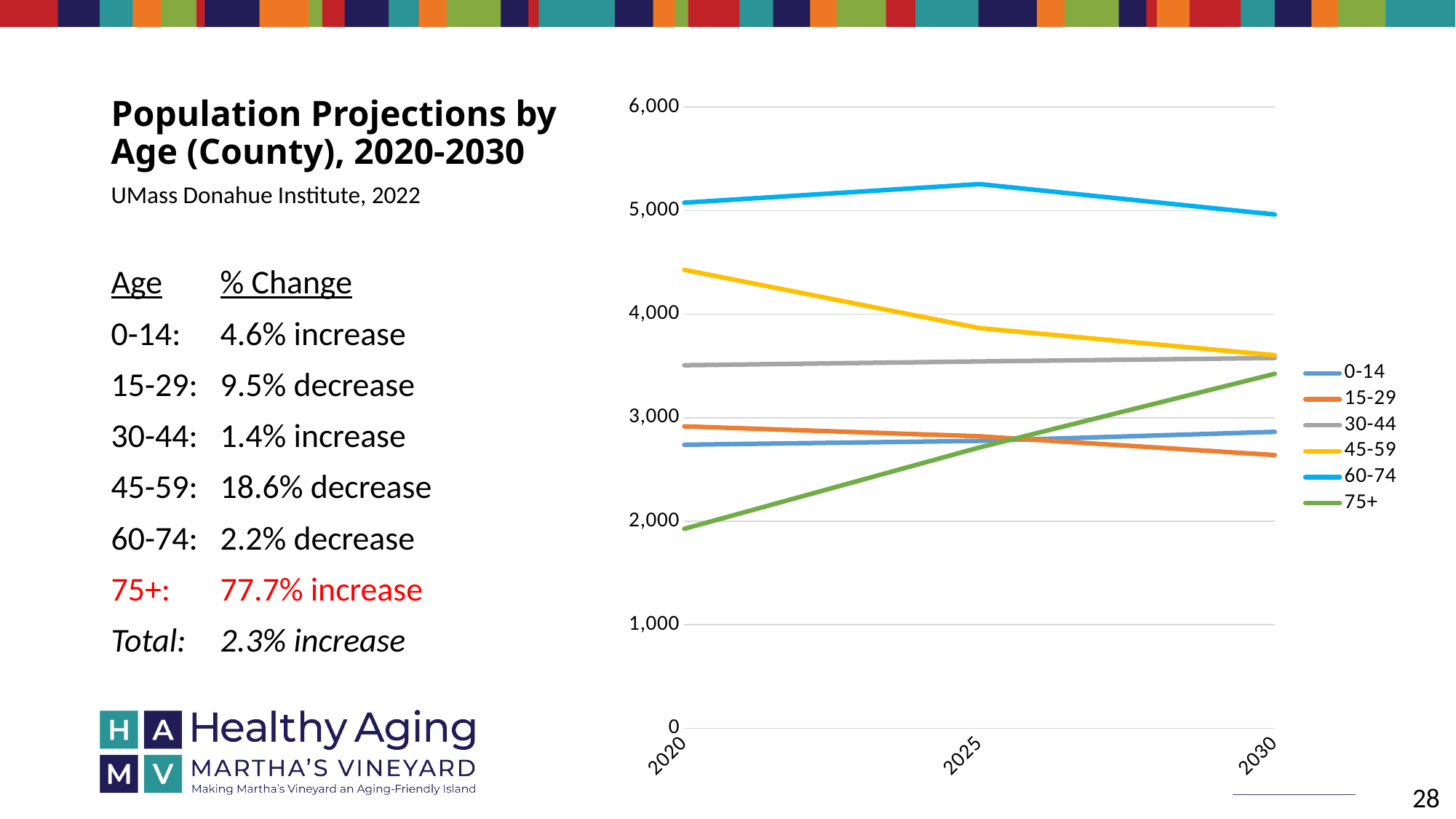
Is the value for the 45-59 age group in 2020 greater or less than 4,000? greater Which age group has the lowest population in 2020? 75+ Is the value for the 60-74 age group in 2025 greater or less than 5,000? greater Which age group has the highest population across the whole chart? 60-74 Does the line for the 45-59 age group rise or fall from 2020 to 2030? fall Is the value for the 75+ age group in 2020 greater or less than 2,000? less Does the line for the 75+ age group rise or fall from 2020 to 2030? rise What kind of chart is shown on the slide? line chart How many series does the chart's legend list? 6 What colour is the line for the 75+ age group? green How many years are marked on the x axis of the chart? 3 In 2030, which is larger: the value for 75+ or the value for 0-14? 75+